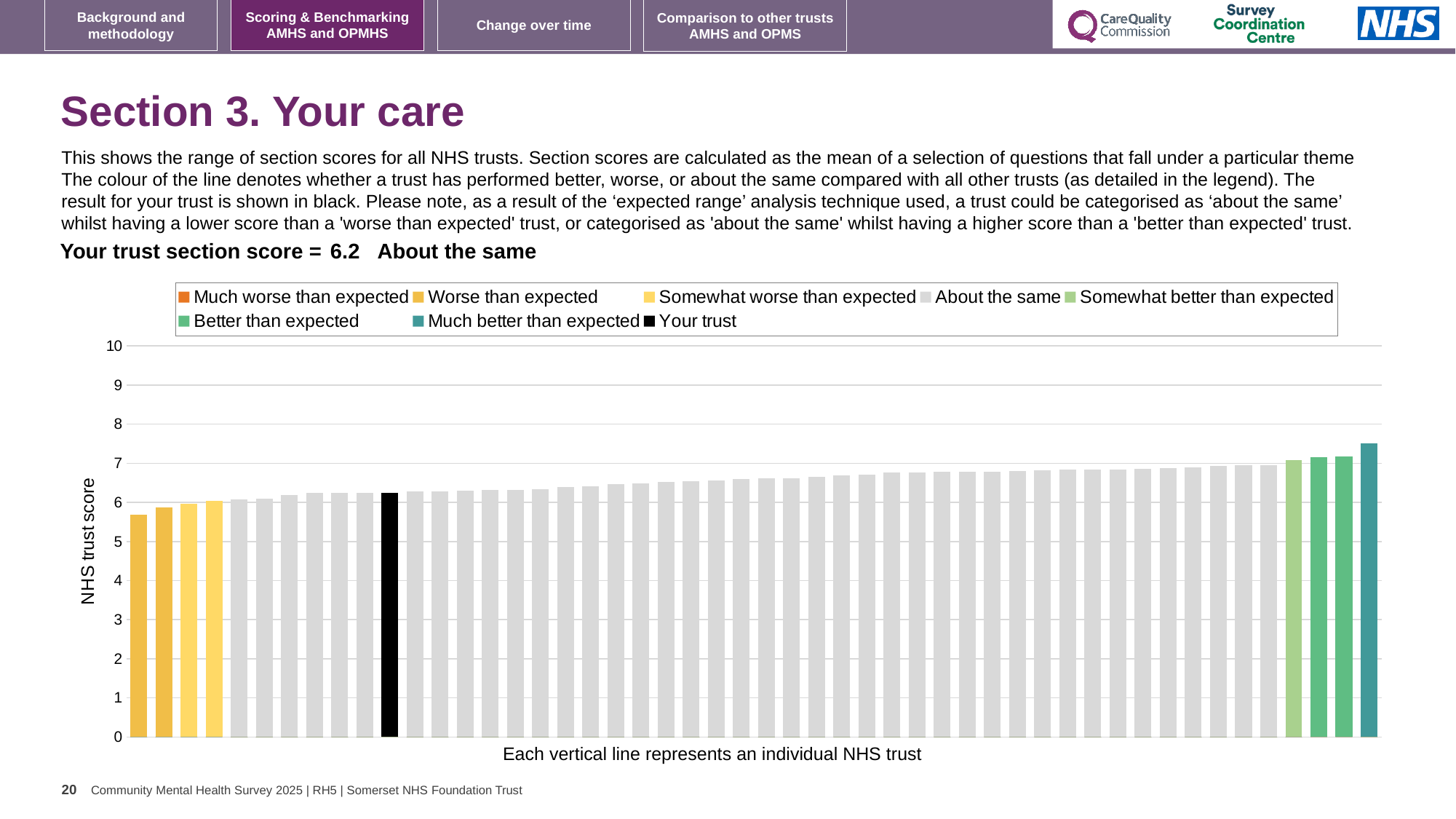
What kind of chart is shown on the slide? bar chart Is the value of the black 'Your trust' bar greater or less than 7? less Do the bar values rise or fall from left to right across the chart? rise Is the value of the tallest bar (rightmost) greater or less than 7? greater How many bars are coloured as 'Much better than expected'? 1 How many bars are coloured as 'Worse than expected'? 2 What colour is the bar representing your trust? black Which performance category is your trust's section score labelled as? About the same Is the value of the black 'Your trust' bar greater or less than 6? greater How many entries does the chart legend list? 8 What is the section score for your trust shown on the slide? 6.2